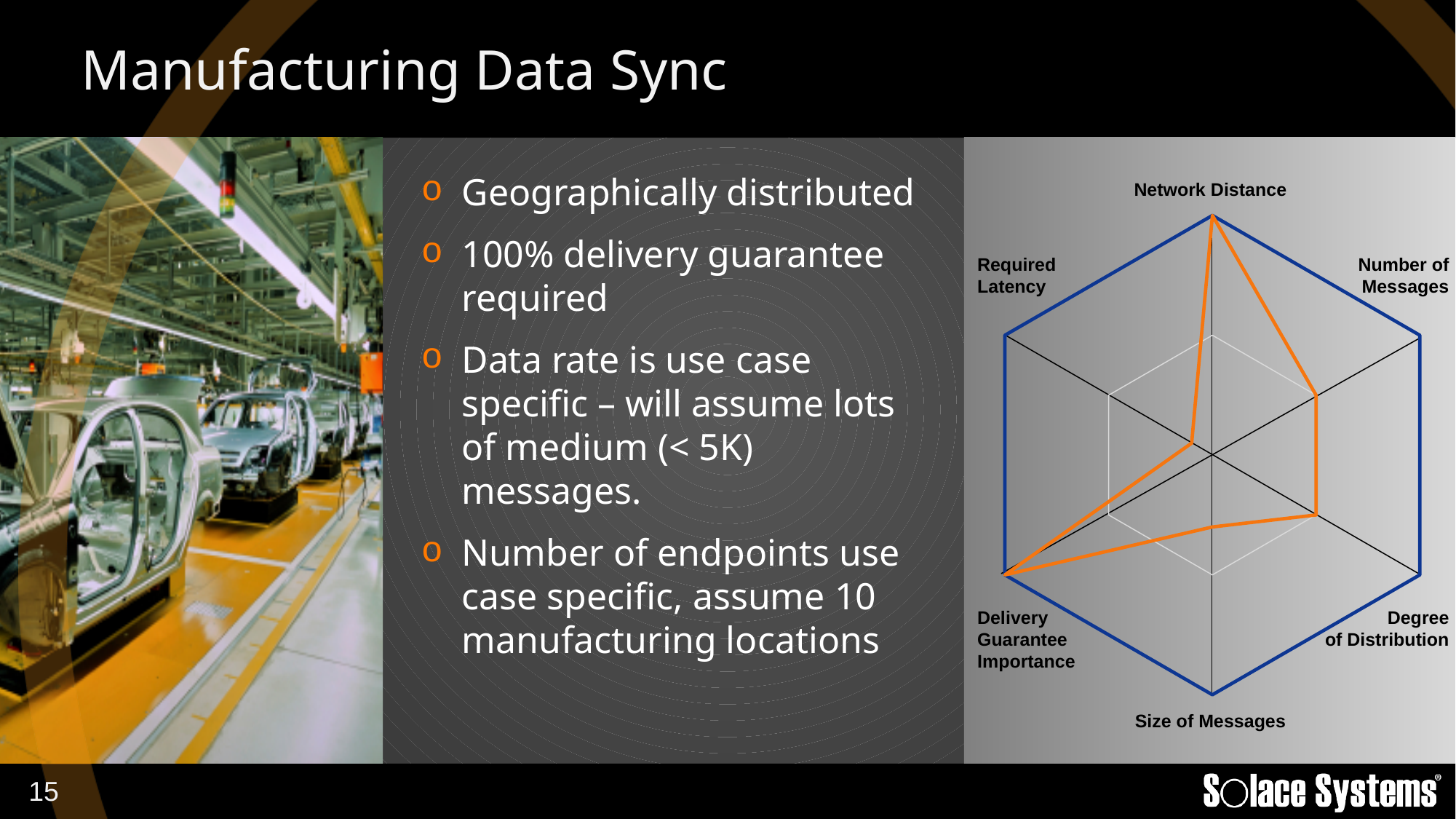
What colour is the plotted data line on the radar chart? Orange Which is larger on the radar chart, the value for Degree of Distribution or the value for Required Latency? Degree of Distribution What kind of chart is shown on the right side of the slide? Radar chart Which axis of the radar chart has the lowest plotted value? Required Latency How many axes (categories) does the radar chart have? 6 Which is larger on the radar chart, the value for Delivery Guarantee Importance or the value for Size of Messages? Delivery Guarantee Importance Which is larger on the radar chart, the value for Number of Messages or the value for Size of Messages? Number of Messages Which axis label appears at the top of the radar chart? Network Distance